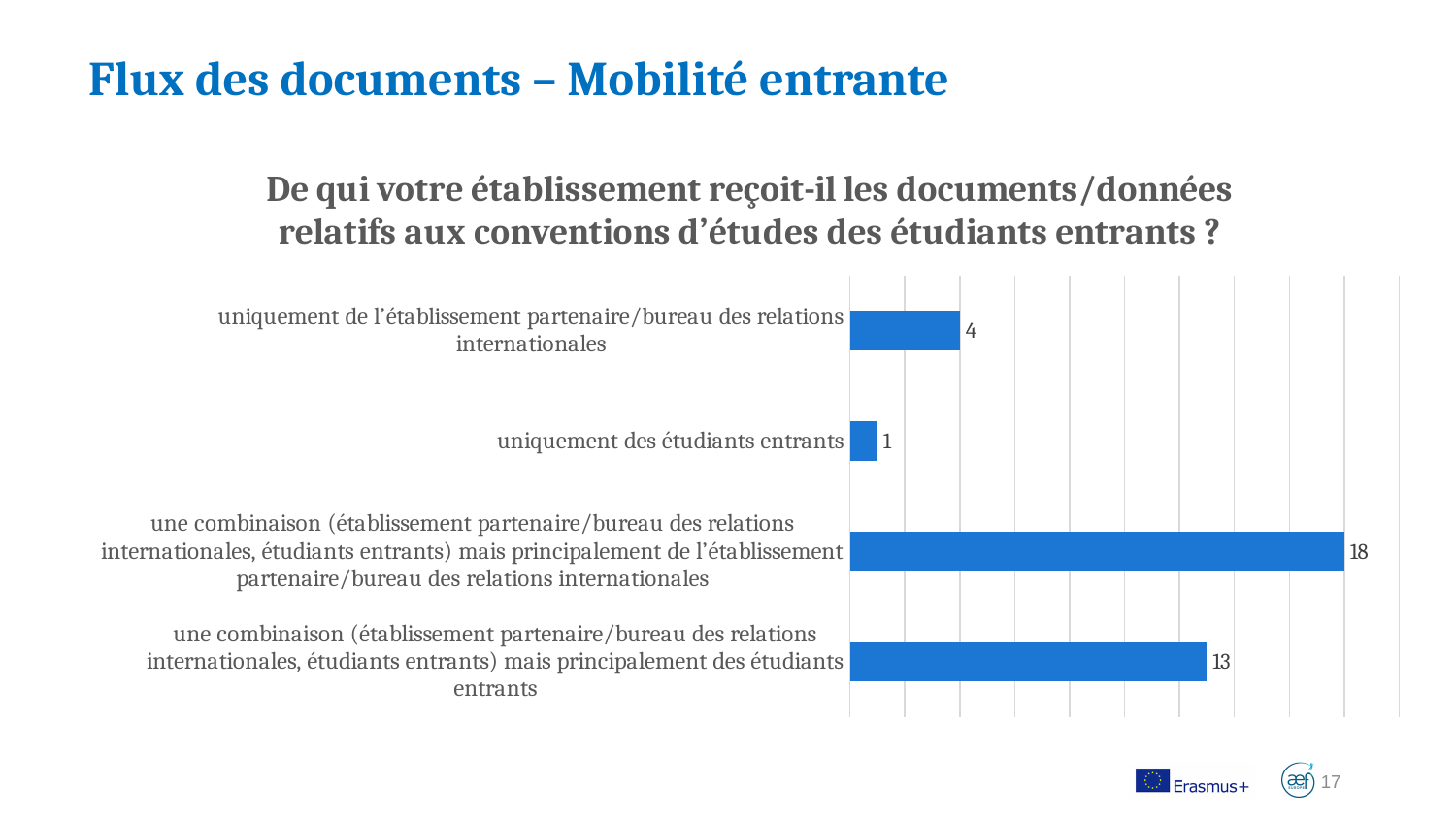
What kind of chart is shown on the slide? bar chart Which category has the lowest value? uniquement des étudiants entrants What value is shown for the combination option that is mainly from the partner institution/international relations office? 18 What is the difference between "uniquement de l'établissement partenaire/bureau des relations internationales" and "uniquement des étudiants entrants"? 3 What is the title of the chart? De qui votre établissement reçoit-il les documents/données relatifs aux conventions d'études des étudiants entrants ? What value is shown for "uniquement de l'établissement partenaire/bureau des relations internationales"? 4 How many categories are shown in the chart? 4 Which category has the highest value? une combinaison (établissement partenaire/bureau des relations internationales, étudiants entrants) mais principalement de l'établissement partenaire/bureau des relations internationales What value is shown for the combination option that is mainly from incoming students? 13 What value is shown for "uniquement des étudiants entrants"? 1 Which is larger: the value for "uniquement de l'établissement partenaire/bureau des relations internationales" or the value for "uniquement des étudiants entrants"? uniquement de l'établissement partenaire/bureau des relations internationales What is the difference between the two combination options (mainly partner institution vs. mainly incoming students)? 5